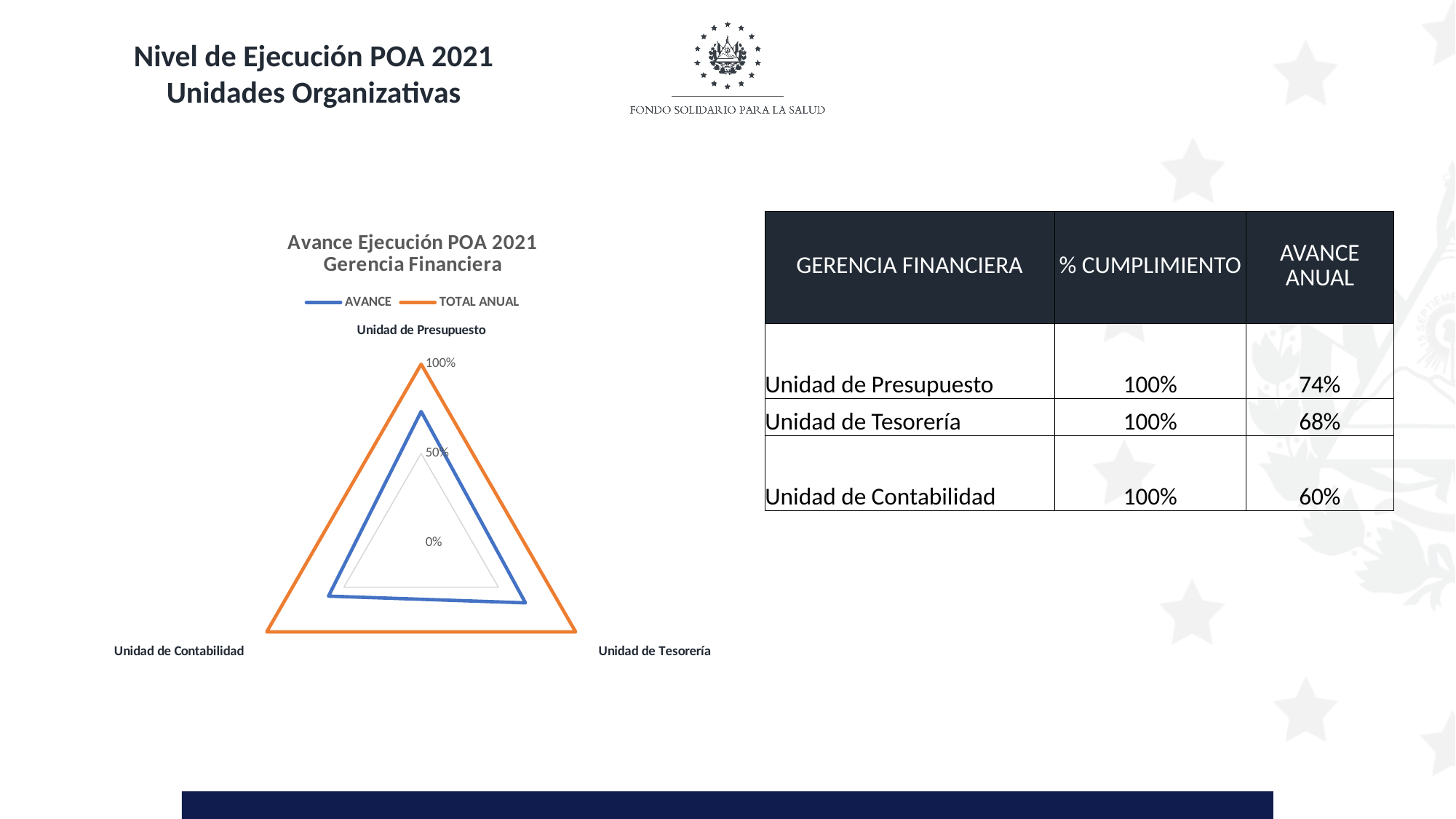
How many series does the legend of the chart list? 2 Which category has the highest AVANCE value? Unidad de Presupuesto How many categories (axes) does the radar chart have? 3 Is the AVANCE value for Unidad de Contabilidad greater or less than 100%? less Which category has the lowest AVANCE value? Unidad de Contabilidad What are the two series named in the chart legend? AVANCE and TOTAL ANUAL What kind of chart is shown on the slide? radar chart What is the TOTAL ANUAL value for Unidad de Presupuesto? 100% Is the AVANCE value for Unidad de Presupuesto greater or less than 50%? greater Which is larger, the AVANCE value for Unidad de Presupuesto or for Unidad de Contabilidad? Unidad de Presupuesto What is the title of the chart? Avance Ejecución POA 2021 Gerencia Financiera According to the table, what is the AVANCE ANUAL value for Unidad de Tesorería? 68%